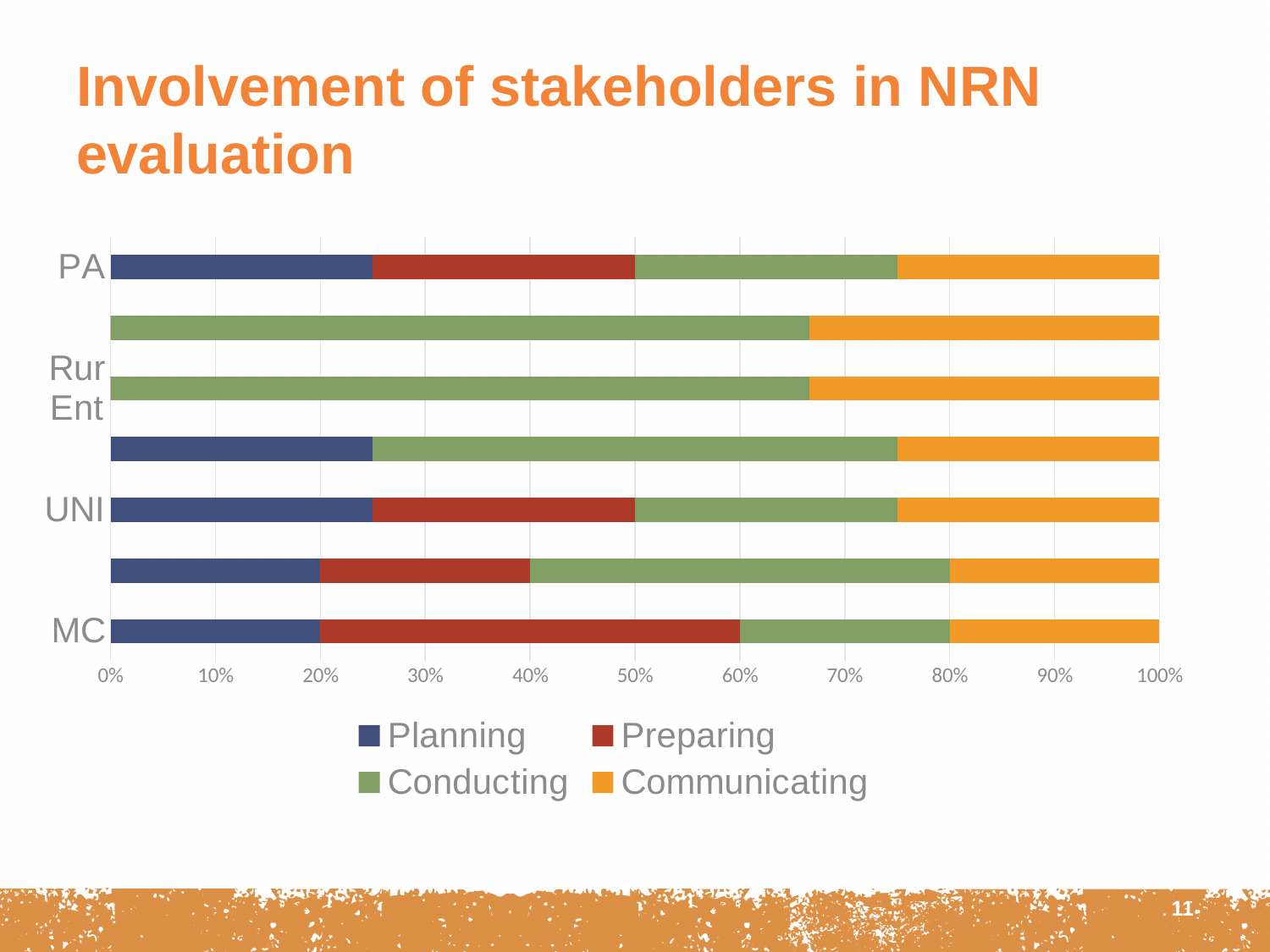
In the MC bar, which series has the largest segment? Preparing What type of chart is shown on the slide? Stacked bar chart What are the four series named in the legend? Planning, Preparing, Conducting, Communicating What is the total of the stacked bar for PA? 100% In the Rur Ent bar, which series has the largest segment? Conducting Is the Conducting segment for Rur Ent greater or less than 60%? greater Is the Planning segment for MC greater or less than 30%? less How many bars are plotted in the chart? 7 In the MC bar, is the Preparing segment or the Planning segment larger? Preparing Is the Communicating segment for Rur Ent greater or less than 40%? less What is the title of the slide containing the chart? Involvement of stakeholders in NRN evaluation How many series does the legend list? 4